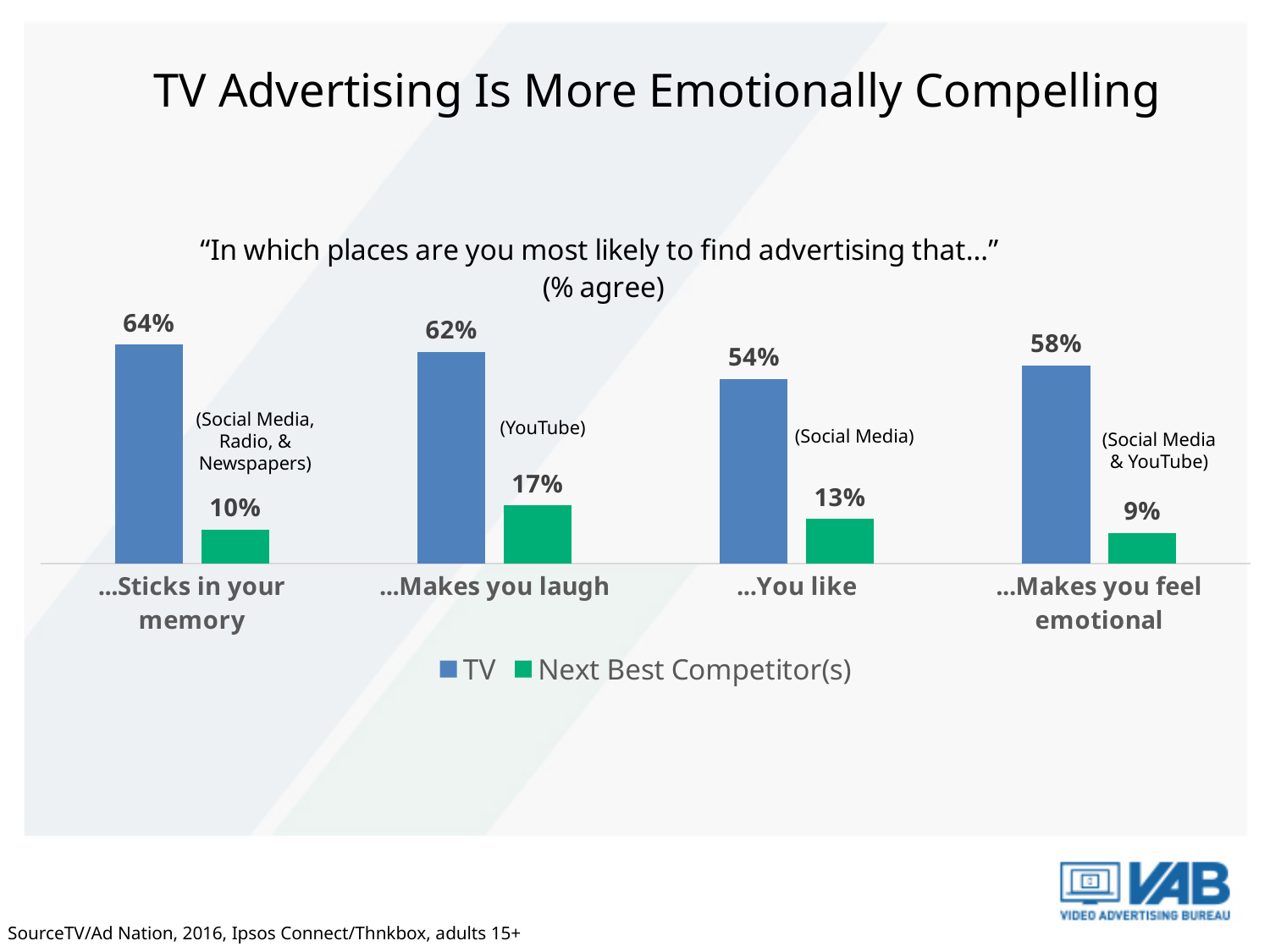
What is the TV value for "...Sticks in your memory"? 64% What is the TV value for "...You like"? 54% Which category has the highest TV value? ...Sticks in your memory Which is larger: the TV value for "...Makes you laugh" or the TV value for "...Makes you feel emotional"? ...Makes you laugh What is the difference between the TV and Next Best Competitor(s) values for "...Sticks in your memory"? 54% What kind of chart is shown on the slide? Bar chart What is the Next Best Competitor(s) value for "...Makes you feel emotional"? 9% Which competitor is named in parentheses for the "...Makes you laugh" category? YouTube How many categories are shown on the x axis? 4 How many series does the legend list? 2 What is the Next Best Competitor(s) value for "...Makes you laugh"? 17% Which category has the lowest Next Best Competitor(s) value? ...Makes you feel emotional